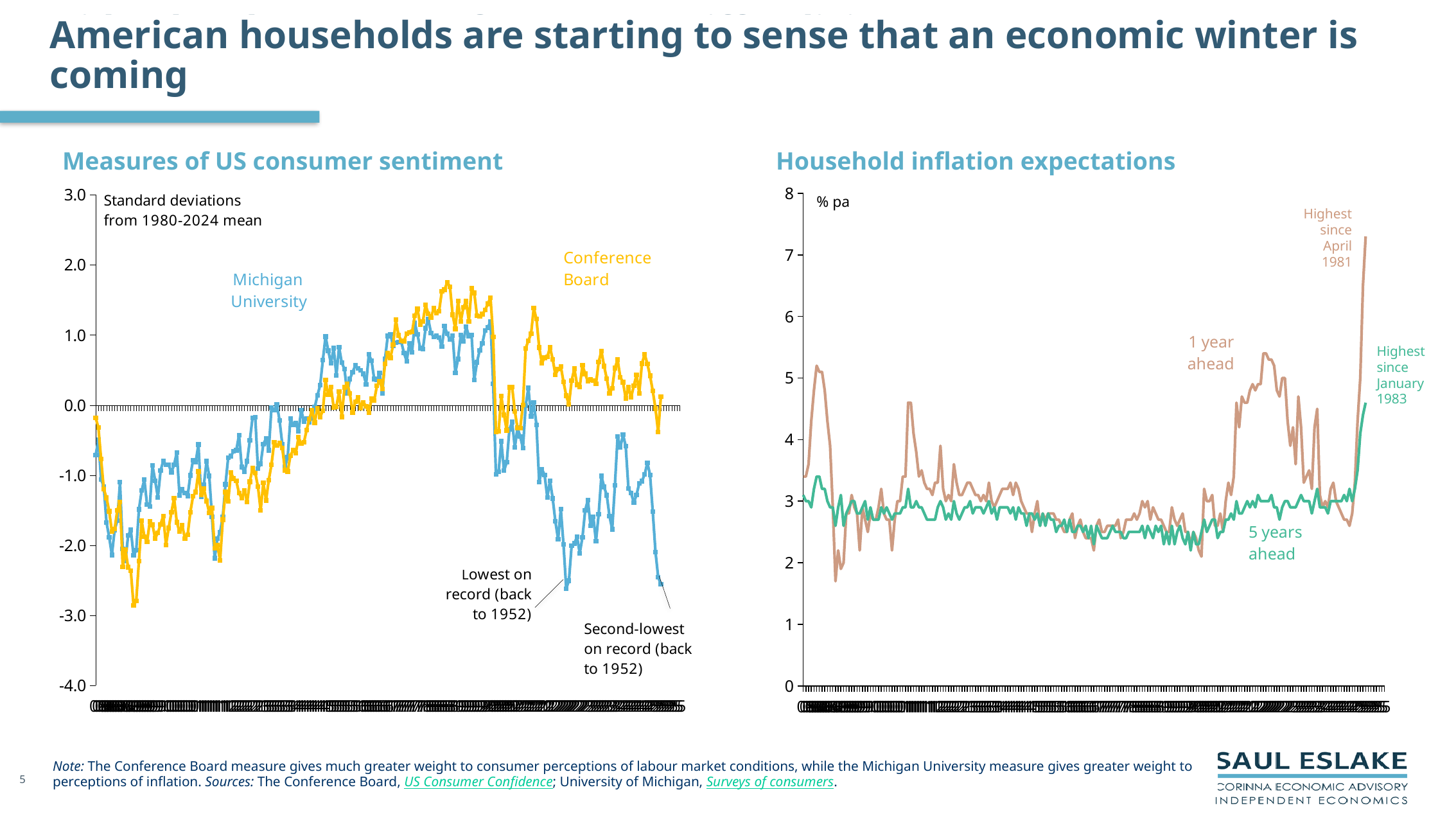
On the 'Measures of US consumer sentiment' chart, which series is higher at the right-hand end of the chart, Michigan University or Conference Board? Conference Board On the 'Household inflation expectations' chart, which series is higher at the right-hand end of the chart, '1 year ahead' or '5 years ahead'? 1 year ahead On the 'Household inflation expectations' chart, which two series are plotted? 1 year ahead and 5 years ahead On the 'Measures of US consumer sentiment' chart, what unit is the vertical axis measured in? Standard deviations from 1980-2024 mean What kind of chart is the 'Household inflation expectations' chart? Line chart How many series are plotted on the 'Household inflation expectations' chart? 2 What kind of chart is the 'Measures of US consumer sentiment' chart? Line chart On the 'Household inflation expectations' chart, is the final value of the '5 years ahead' series greater or less than 4? greater On the 'Measures of US consumer sentiment' chart, is the lowest value of the Michigan University series greater or less than -2.0? less On the 'Measures of US consumer sentiment' chart, is the highest value of the Conference Board series greater or less than 1.0? greater How many series are plotted on the 'Measures of US consumer sentiment' chart? 2